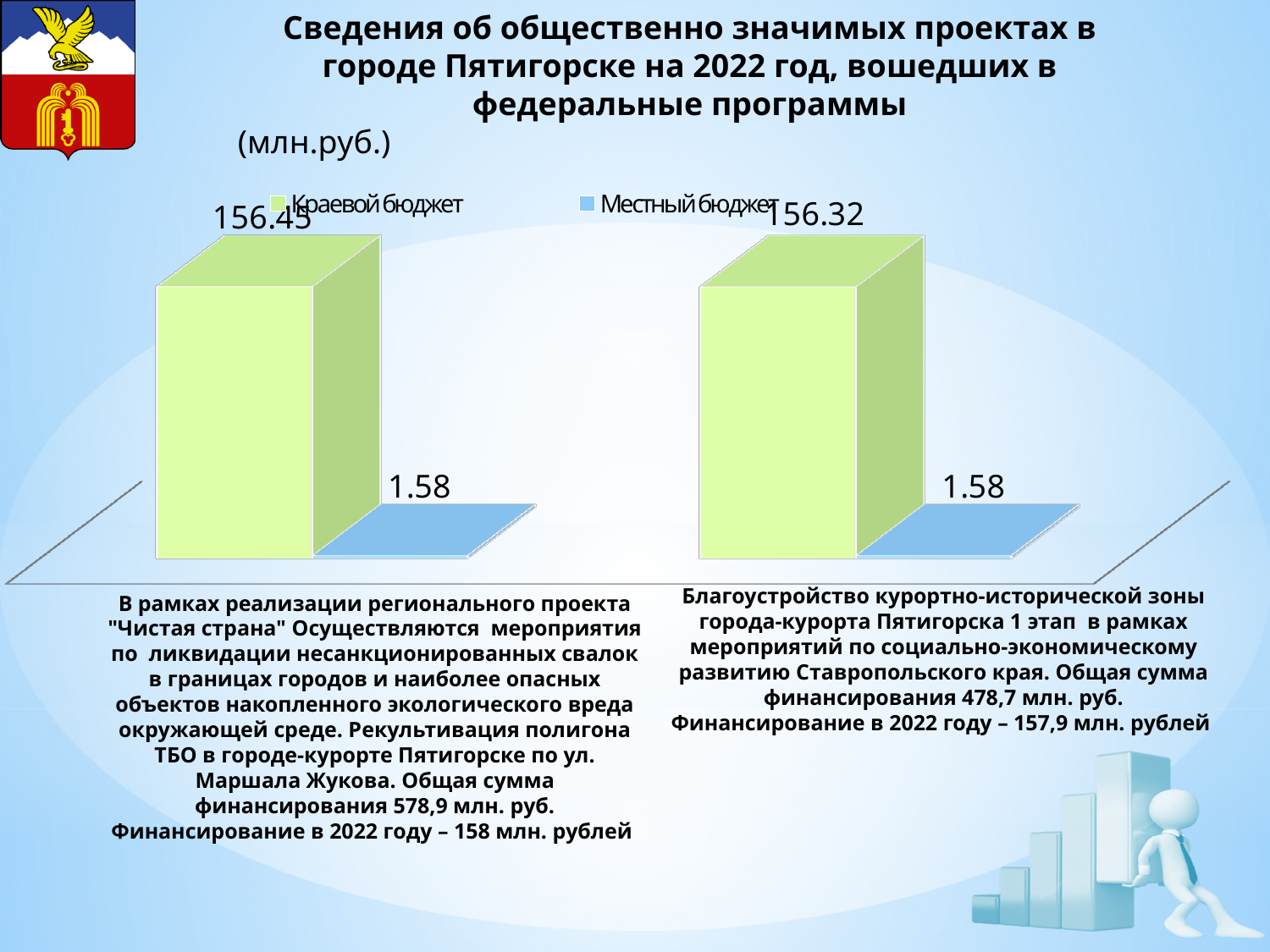
What is the value of Местный бюджет for the "Благоустройство курортно-исторической зоны" project (right group)? 1.58 Which series has the higher value for the "Чистая страна" project: Краевой бюджет or Местный бюджет? Краевой бюджет What is the difference between the Краевой бюджет values of the two projects? 0.13 How many series does the chart legend list? 2 What is the value of Местный бюджет for the "Чистая страна" project (left group)? 1.58 What is the difference between Краевой бюджет and Местный бюджет for the "Благоустройство курортно-исторической зоны" project (right group)? 154.74 What are the two series named in the chart legend? Краевой бюджет and Местный бюджет What is the difference between Краевой бюджет and Местный бюджет for the "Чистая страна" project (left group)? 154.87 What type of chart is shown on the slide? bar chart How many project categories are plotted on the chart? 2 What is the value of Краевой бюджет for the "Чистая страна" project (left group)? 156.45 What is the value of Краевой бюджет for the "Благоустройство курортно-исторической зоны" project (right group)? 156.32